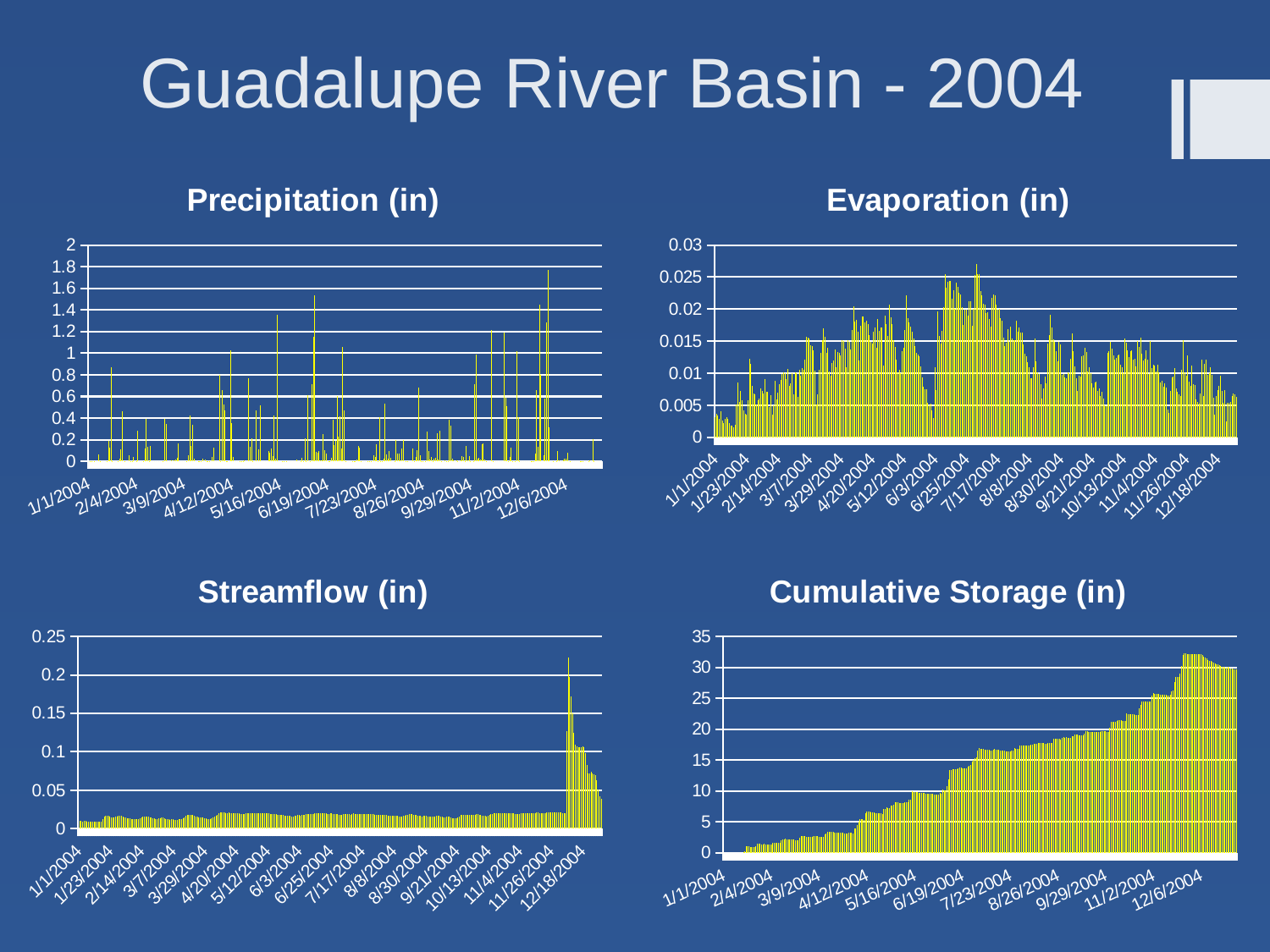
In the Precipitation (in) chart, is the tallest bar greater or less than 1.4? greater In the Streamflow (in) chart, is the value at 6/3/2004 greater or less than 0.05? less In the Streamflow (in) chart, is the highest value greater or less than 0.15? greater What kind of chart is the Cumulative Storage (in) chart? bar chart What is the maximum value shown on the y axis of the Streamflow (in) chart? 0.25 How many charts are shown on the slide? 4 What is the title of the chart in the top-right position of the slide? Evaporation (in) In the Cumulative Storage (in) chart, do the values generally rise or fall across the year? rise